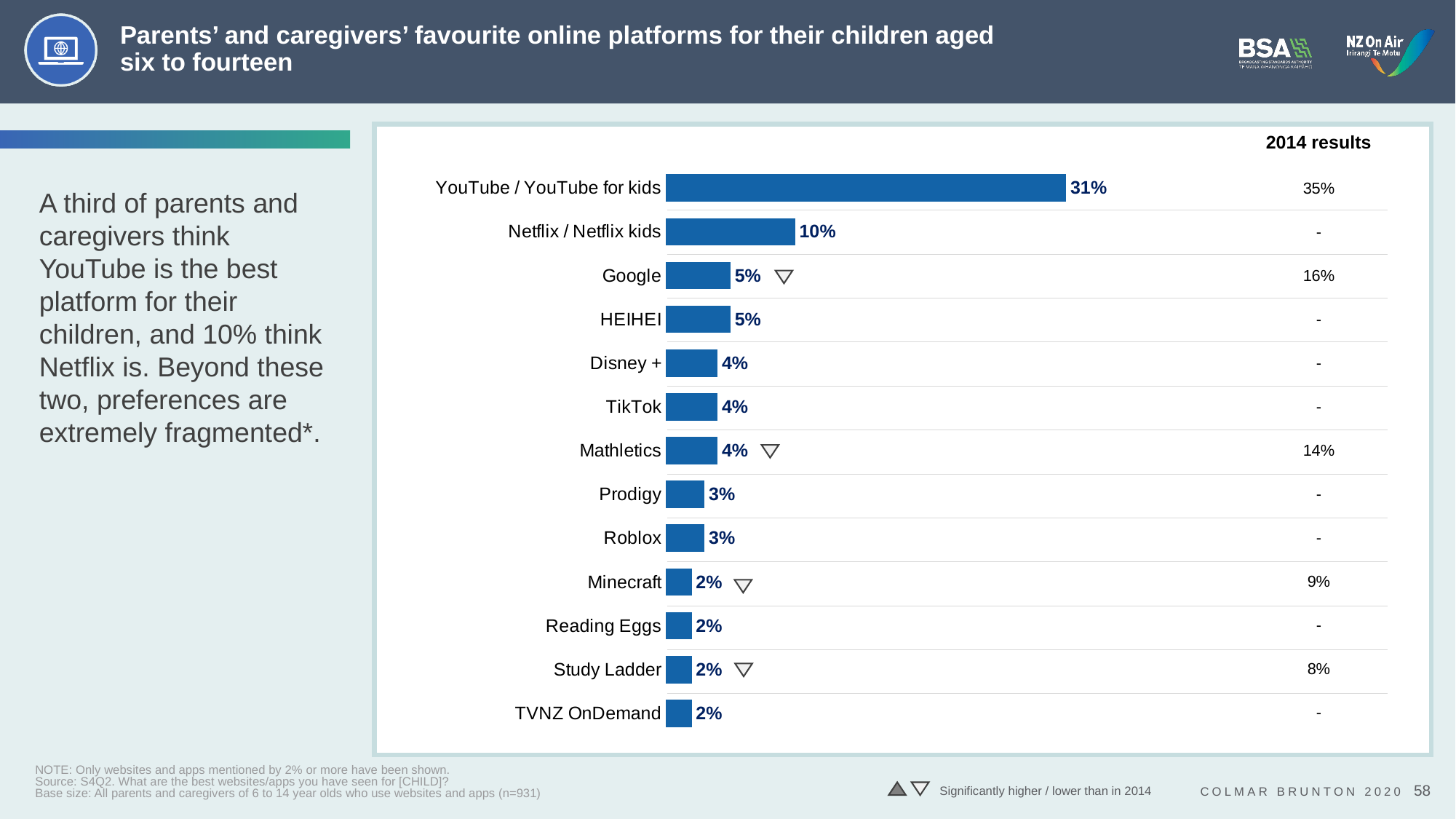
What percentage of parents and caregivers chose YouTube / YouTube for kids as a favourite platform? 31% How many platforms are listed in the chart? 13 What is the value shown for Mathletics? 4% Which platform has the highest value in the chart? YouTube / YouTube for kids What was the 2014 result for Google? 16% What is the value shown for Netflix / Netflix kids? 10% What kind of chart is shown on the slide? Bar chart Which has a larger value, Google or Prodigy? Google What is the difference between the 2014 result and the current value for Mathletics? 10% What was the 2014 result for Minecraft? 9% What is the heading of the column of values on the right side of the chart? 2014 results What is the difference between the values for YouTube / YouTube for kids and Netflix / Netflix kids? 21%